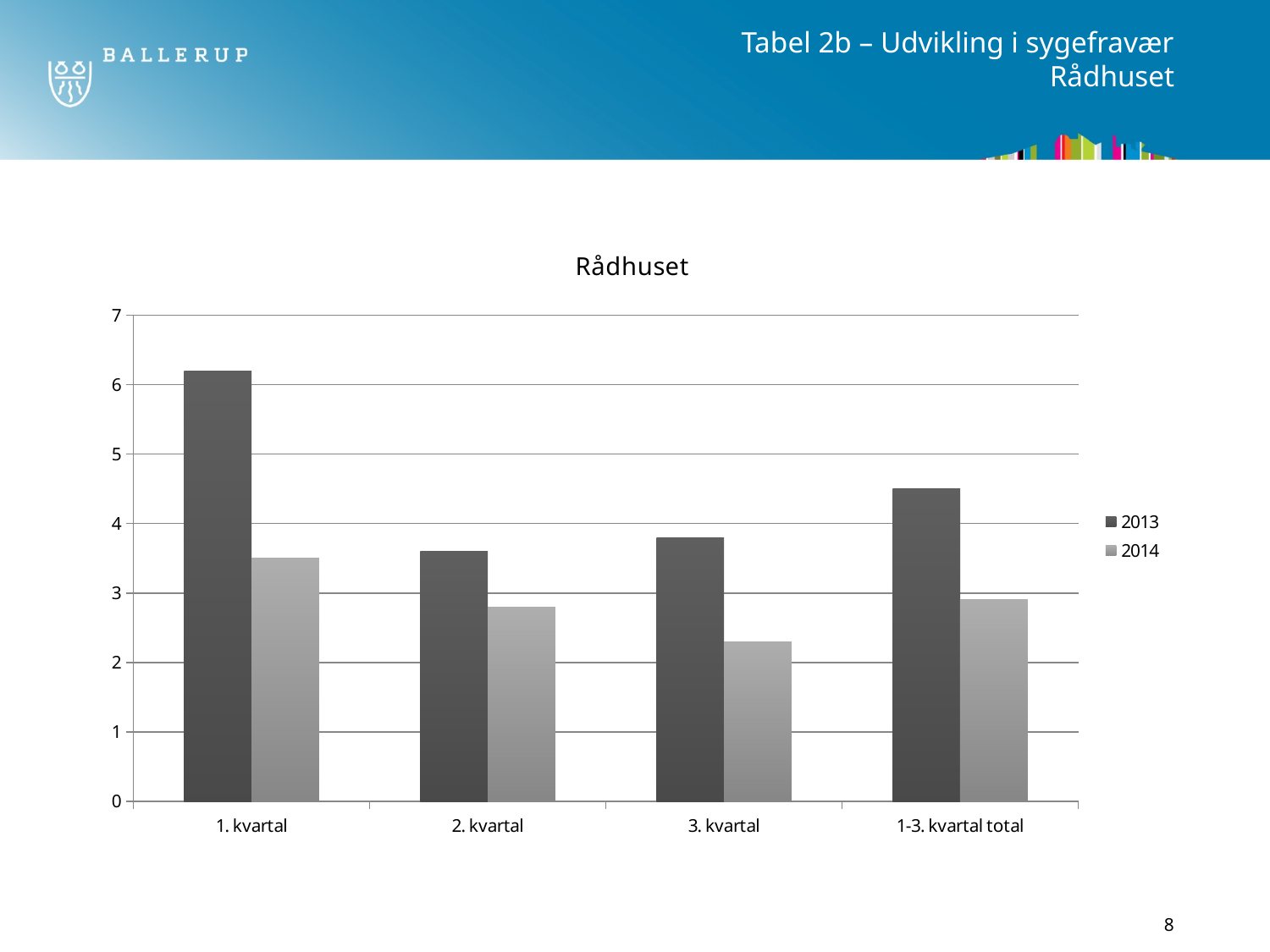
What kind of chart is shown on the slide? bar chart Which category has the lowest value for the 2014 series? 3. kvartal How many categories are shown on the x axis? 4 Is the 2013 value for 1-3. kvartal total greater or less than 4? greater Which category has the highest value for the 2013 series? 1. kvartal Is the 2014 value for 3. kvartal greater or less than 3? less Is the 2013 value for 1. kvartal greater or less than 6? greater Which series is shown in the lighter grey bars? 2014 How many series does the legend list? 2 For 2. kvartal, which series has the larger value, 2013 or 2014? 2013 Which category has the highest value for the 2014 series? 1. kvartal What is the title of the chart? Rådhuset